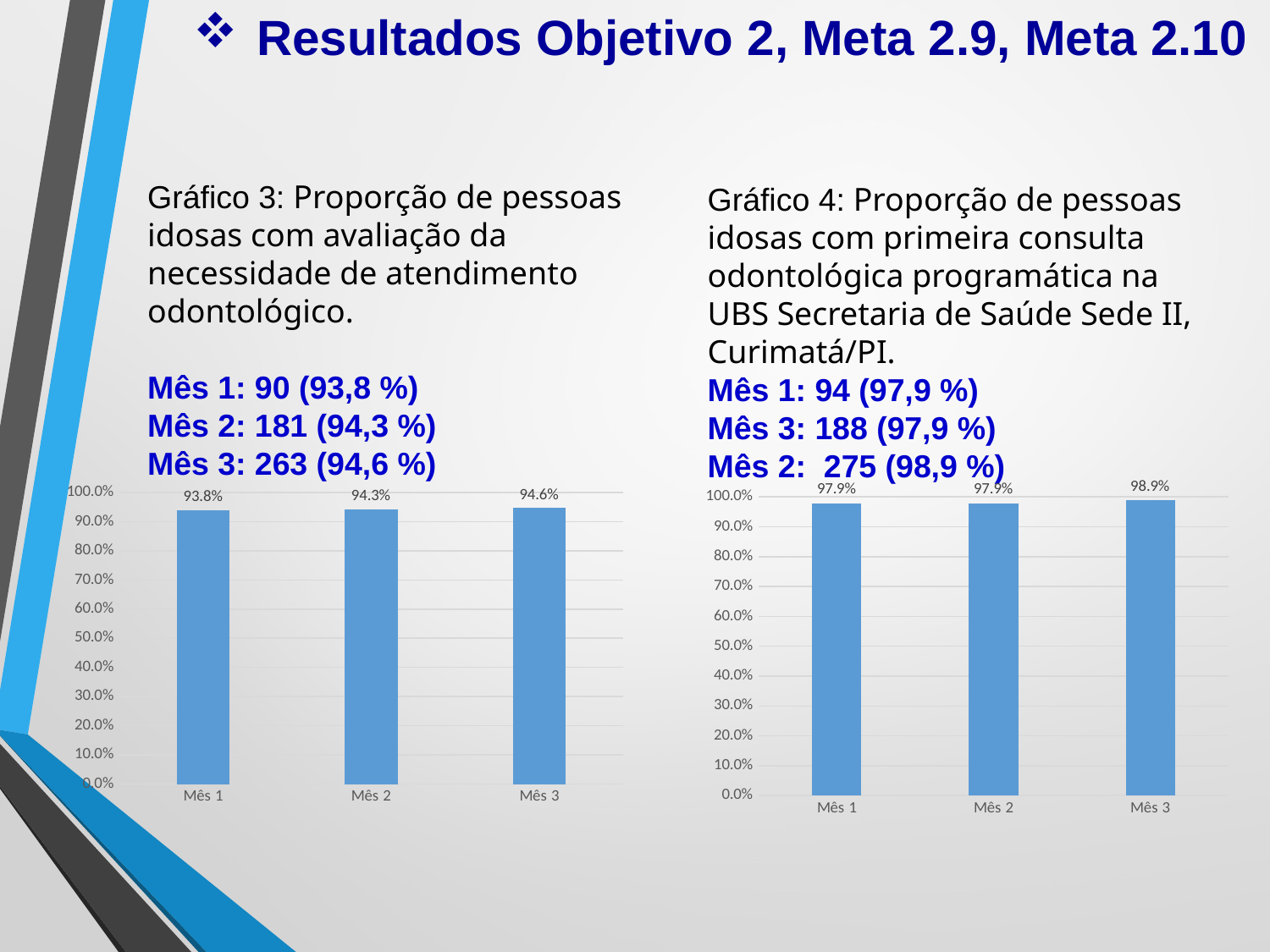
How many bars does the left chart (Gráfico 3) show? 3 In the right chart (Gráfico 4), what is the difference between the values for Mês 3 and Mês 1? 1.0 percentage point In the right chart (Gráfico 4), what is the value for Mês 3? 98.9% In the left chart (Gráfico 3), what is the difference between the values for Mês 3 and Mês 1? 0.8 percentage points In the left chart (Gráfico 3), what is the value for Mês 1? 93.8% In the right chart (Gráfico 4), which month has the highest value? Mês 3 In the left chart (Gráfico 3), which month has the highest value? Mês 3 In the right chart (Gráfico 4), what is the value for Mês 2? 97.9% In the left chart (Gráfico 3), what is the value for Mês 3? 94.6% What type of chart is the right chart (Gráfico 4)? Bar chart In the left chart (Gráfico 3), do the values rise or fall from Mês 1 to Mês 3? Rise In the left chart (Gráfico 3), which month has the lowest value? Mês 1